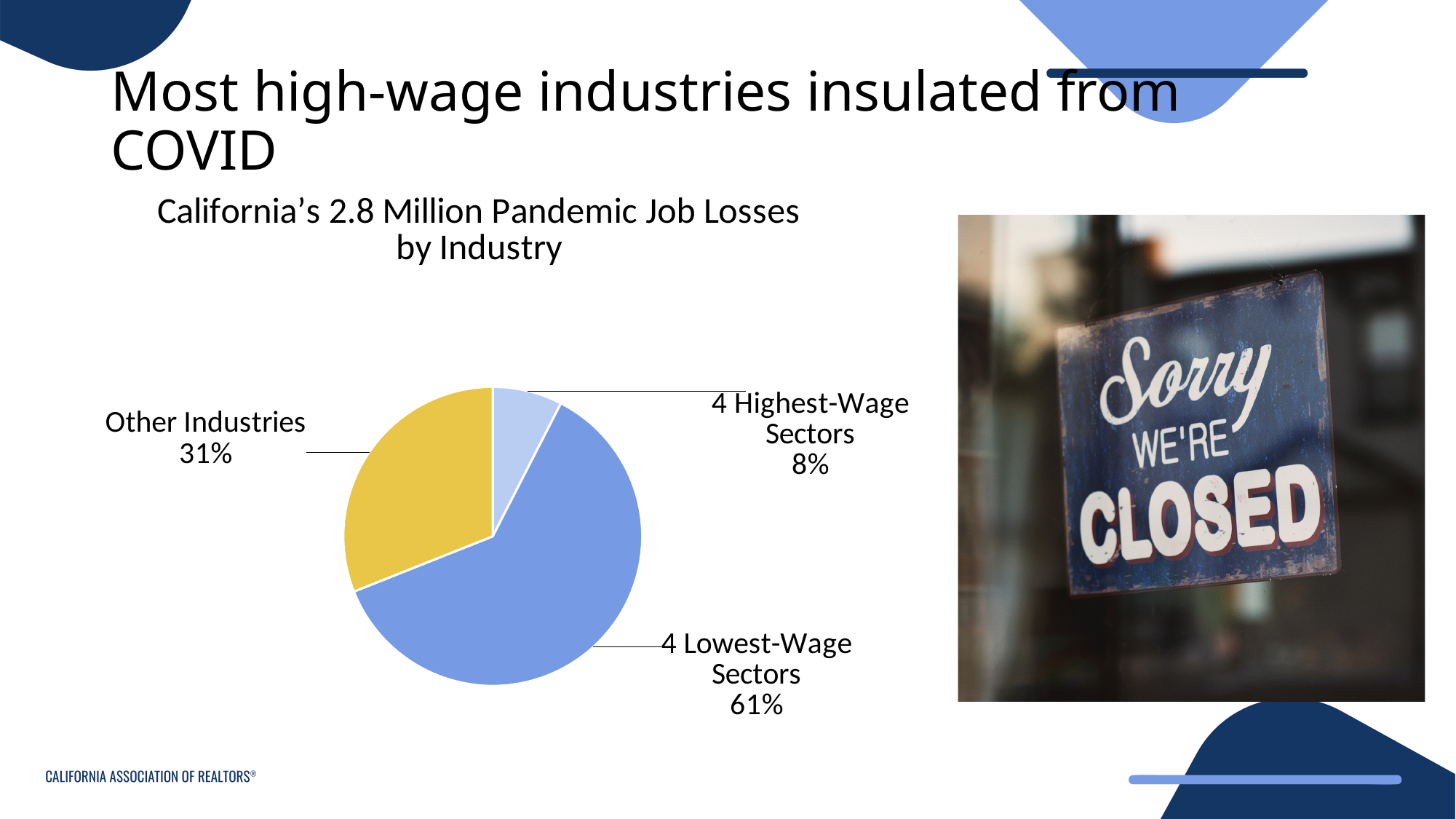
Which is larger: the share for Other Industries or the share for the 4 Highest-Wage Sectors? Other Industries What share of the pie is labelled 4 Highest-Wage Sectors? 8% Which category accounts for the smallest share of job losses? 4 Highest-Wage Sectors What colour is the Other Industries slice? Yellow What type of chart is shown on the slide? Pie chart Which category accounts for the largest share of job losses? 4 Lowest-Wage Sectors What percentage of job losses is attributed to Other Industries? 31% What is the difference in percentage points between Other Industries and the 4 Highest-Wage Sectors? 23 What is the title of the chart? California's 2.8 Million Pandemic Job Losses by Industry What share of California's pandemic job losses came from the 4 Lowest-Wage Sectors? 61% How many slices does the pie chart have? 3 How many percentage points larger is the 4 Lowest-Wage Sectors share than the Other Industries share? 30